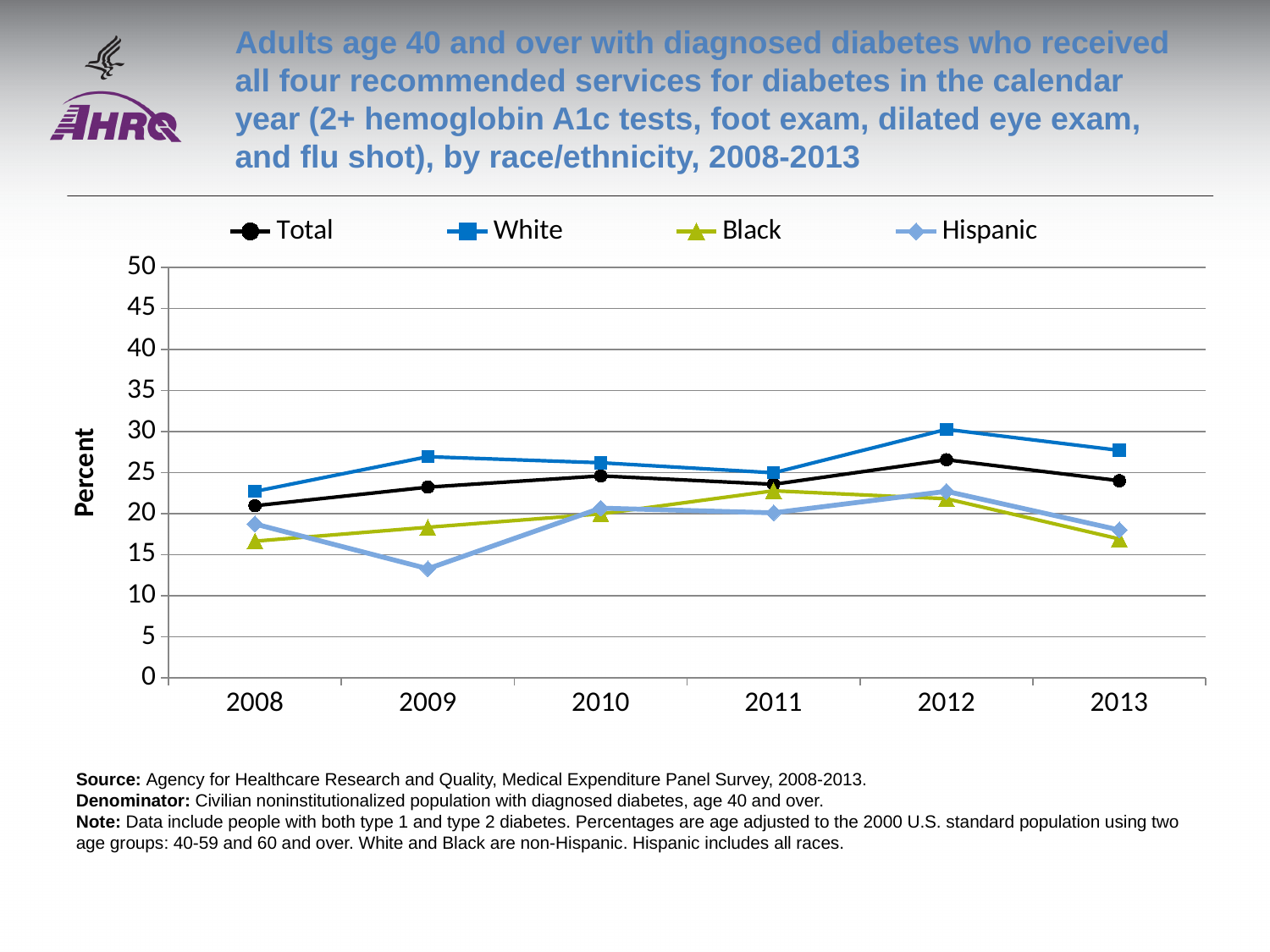
Does the White series rise or fall from 2011 to 2012? rise Is the value for White in 2012 greater or less than 25? greater Is the value for Hispanic in 2009 greater or less than 15? less How many series does the legend list? 4 Is the value for Black in 2008 greater or less than 20? less In which year is the White series at its highest? 2012 In which year is the Hispanic series at its lowest? 2009 In 2008, which is larger, the value for Hispanic or the value for Black? Hispanic What kind of chart is shown on the slide? line chart In 2013, which is larger, the value for White or the value for Black? White How many years are plotted along the x axis? 6 What is the label on the y axis? Percent